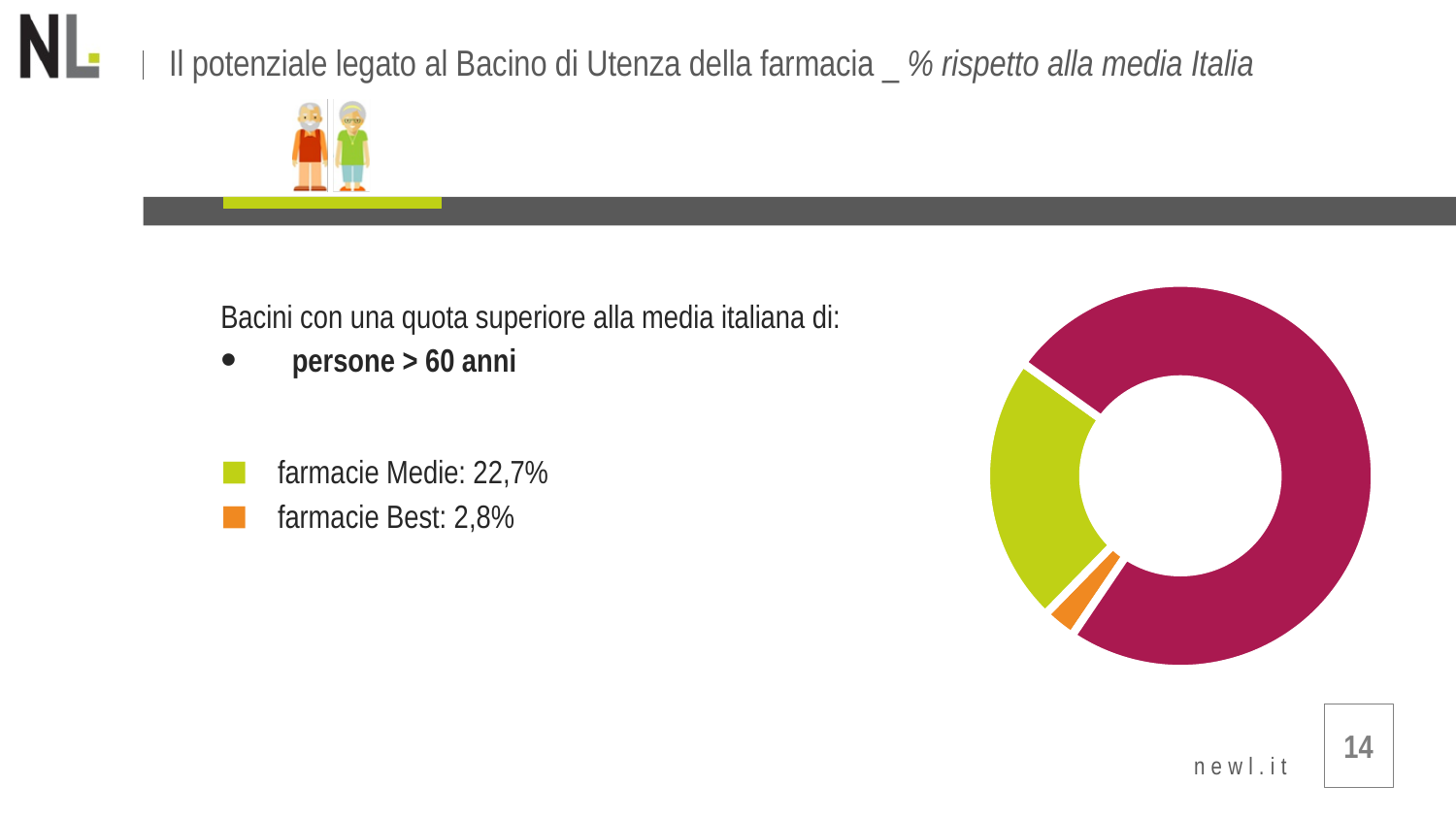
What kind of chart is shown on the slide? doughnut (pie) chart What is the difference between the values for farmacie Medie and farmacie Best? 19,9% Which colour represents farmacie Medie in the chart? green What is the value shown for farmacie Medie? 22,7% What is the value shown for farmacie Best? 2,8% Of the two labelled categories, which has the smallest value? farmacie Best Is the value for farmacie Medie greater or less than 20%? greater Which colour slice is the largest in the doughnut chart? magenta (dark pink) Which colour represents farmacie Best in the chart? orange Which is larger, the value for farmacie Medie or for farmacie Best? farmacie Medie How many slices does the doughnut chart have? 3 How many entries does the legend list? 2